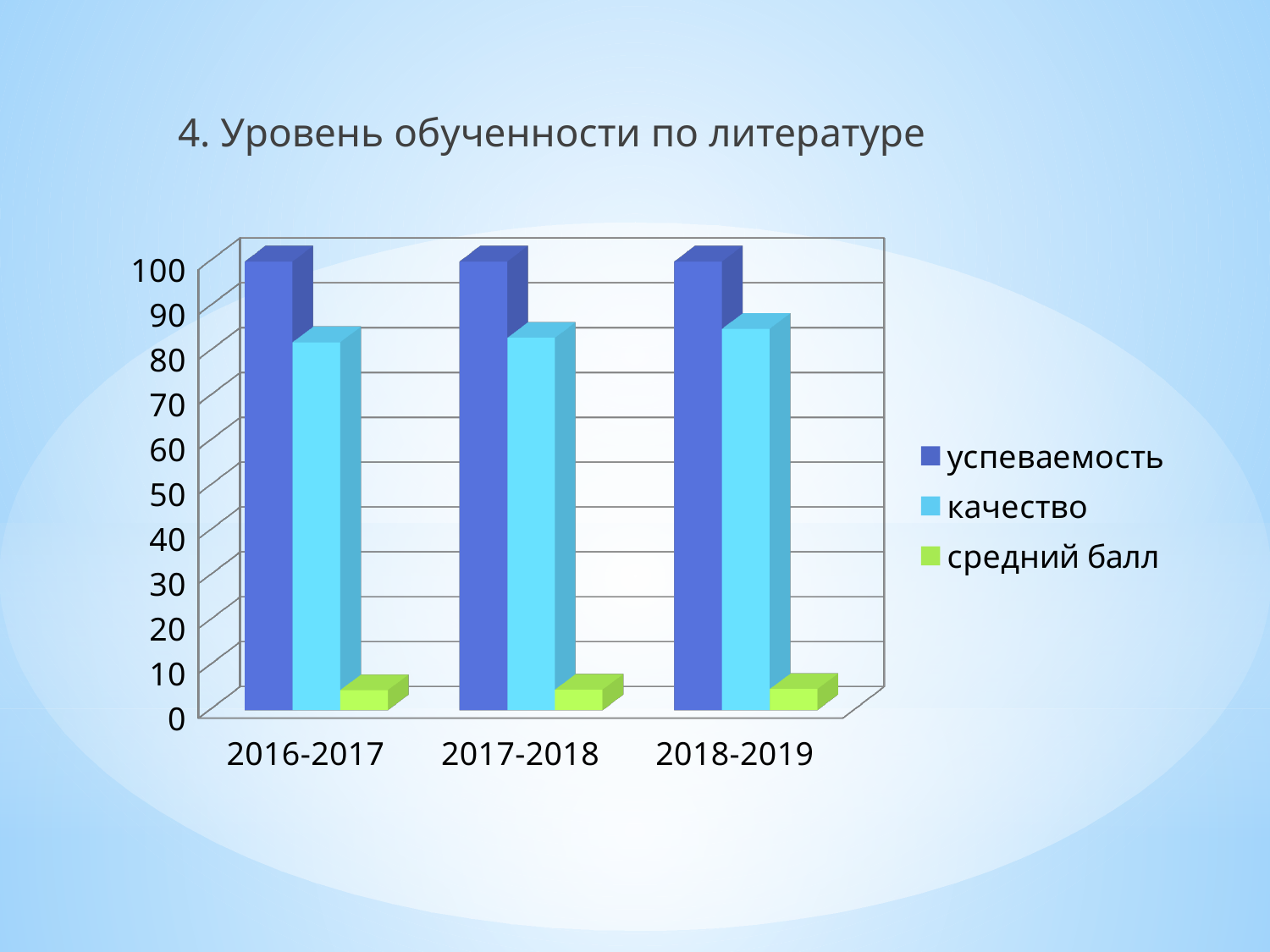
In 2018-2019, which is larger: качество or средний балл? качество Is the value for средний балл in 2017-2018 greater or less than 10? less What is the title of the slide? 4. Уровень обученности по литературе Is the value for успеваемость in 2017-2018 greater or less than 90? greater Which series has the highest value in 2016-2017? успеваемость Which series has the lowest value in 2018-2019? средний балл Which series is shown in green in the legend? средний балл Is the value for качество in 2018-2019 greater or less than 90? less What kind of chart is shown on the slide? bar chart How many series does the legend list? 3 How many academic years are shown on the x axis? 3